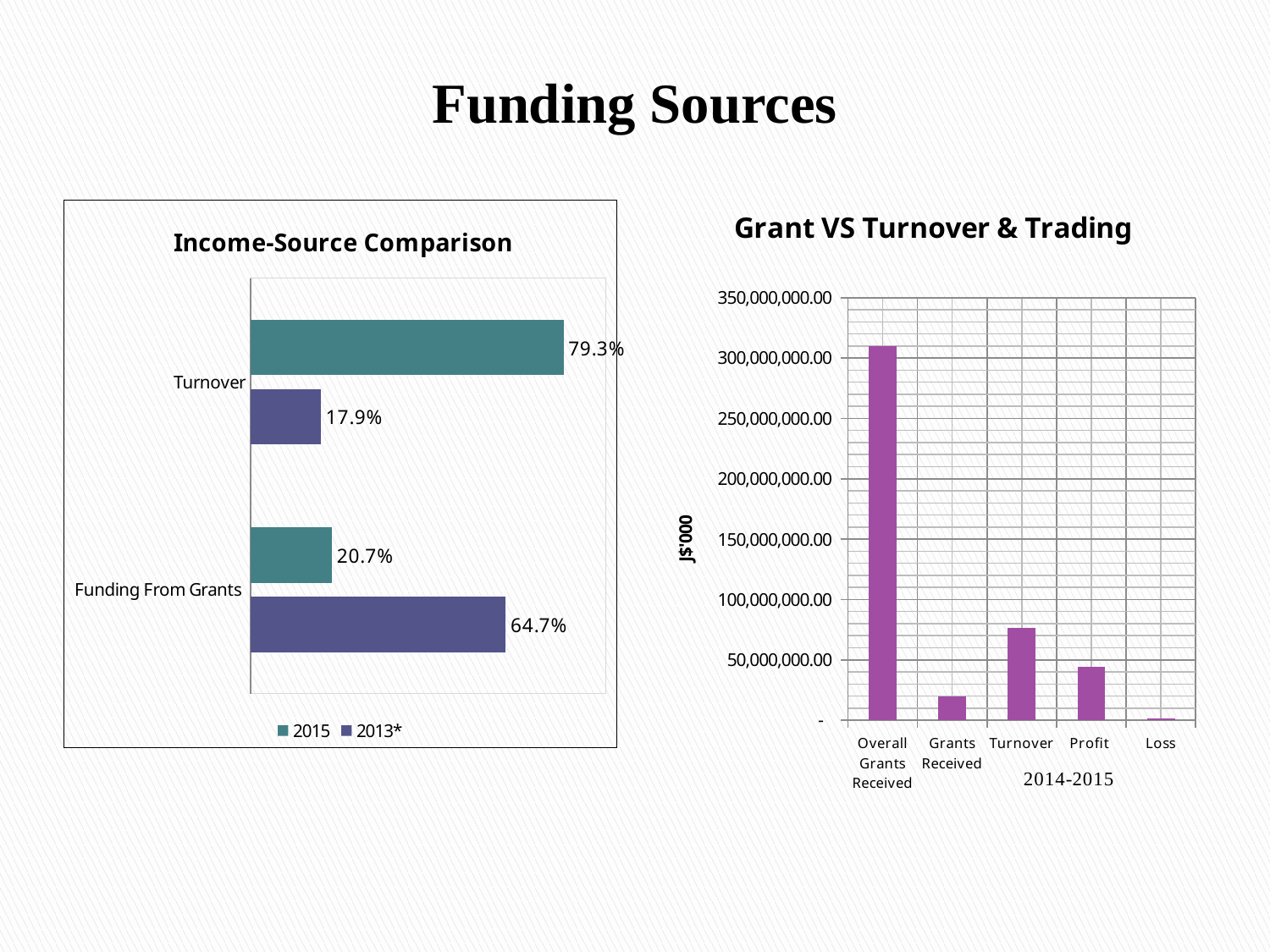
In the Grant VS Turnover & Trading chart, is the value for Overall Grants Received greater or less than 300,000,000.00? greater In the Income-Source Comparison chart, which is larger for Funding From Grants: the 2015 value or the 2013* value? 2013* In the Grant VS Turnover & Trading chart, which category has the lowest value? Loss In the Income-Source Comparison chart, what is the 2015 value for Turnover? 79.3% In the Grant VS Turnover & Trading chart, which category has the highest value? Overall Grants Received In the Income-Source Comparison chart, what is the 2013* value for Funding From Grants? 64.7% In the Grant VS Turnover & Trading chart, is the value for Turnover greater or less than 100,000,000.00? less In the Income-Source Comparison chart, what is the 2015 value for Funding From Grants? 20.7% In the Income-Source Comparison chart, what is the difference between the 2015 and 2013* values for Turnover? 61.4% How many series does the legend of the Income-Source Comparison chart list? 2 How many categories are shown on the x axis of the Grant VS Turnover & Trading chart? 5 What kind of chart is the Income-Source Comparison chart? Bar chart